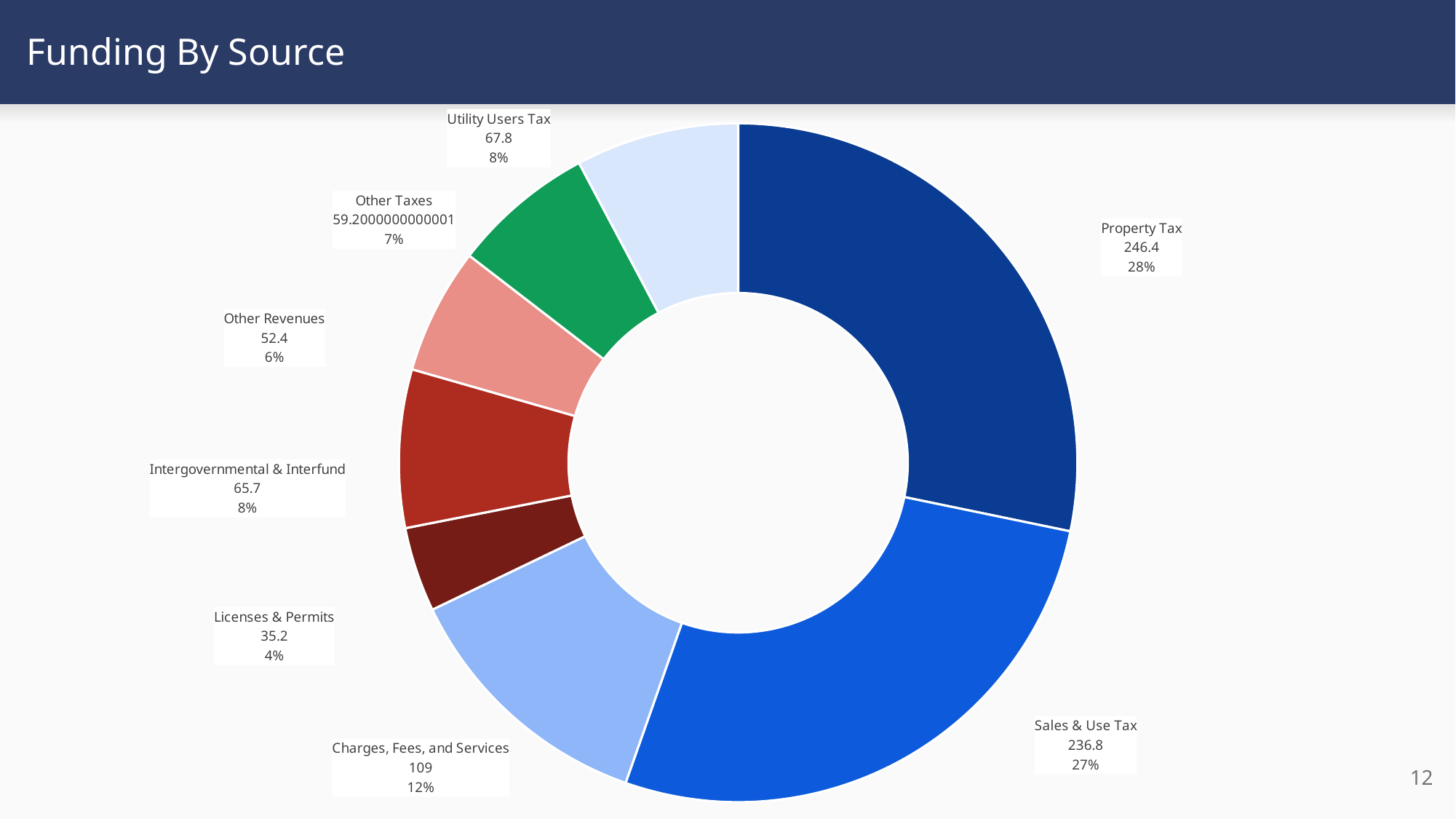
What is the value shown for Property Tax? 246.4 What is the difference between the Property Tax value and the Sales & Use Tax value? 9.6 Which funding source has the largest share? Property Tax What percentage share does Licenses & Permits have? 4% How many funding sources are shown in the chart? 8 Which funding source has the smallest share? Licenses & Permits What is the value shown for Intergovernmental & Interfund? 65.7 What percentage share does Sales & Use Tax have? 27% What is the value shown for Charges, Fees, and Services? 109 What kind of chart is shown on the slide? Donut (pie) chart Which is larger, Utility Users Tax or Other Revenues? Utility Users Tax What is the title of the slide? Funding By Source